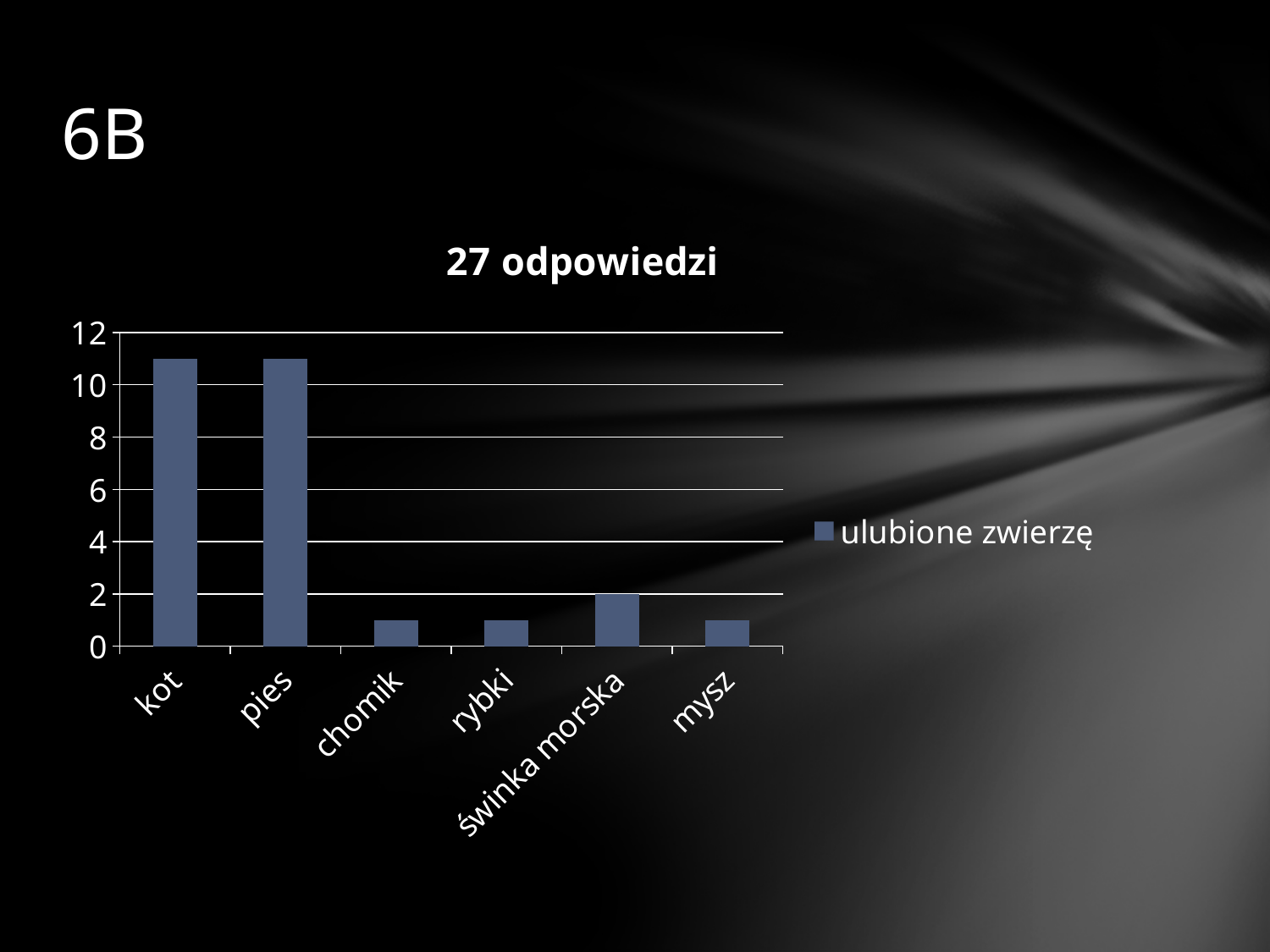
What series name does the legend show? ulubione zwierzę What is the value for świnka morska? 2 Which has the larger value, kot or chomik? kot Is the value for pies greater or less than 8? greater Is the value for mysz greater or less than 4? less What is the title of the chart? 27 odpowiedzi Which has the larger value, świnka morska or rybki? świnka morska What kind of chart is shown on the slide? bar chart Is the value for chomik greater or less than 2? less How many series does the legend list? 1 How many categories are shown on the x axis of the chart? 6